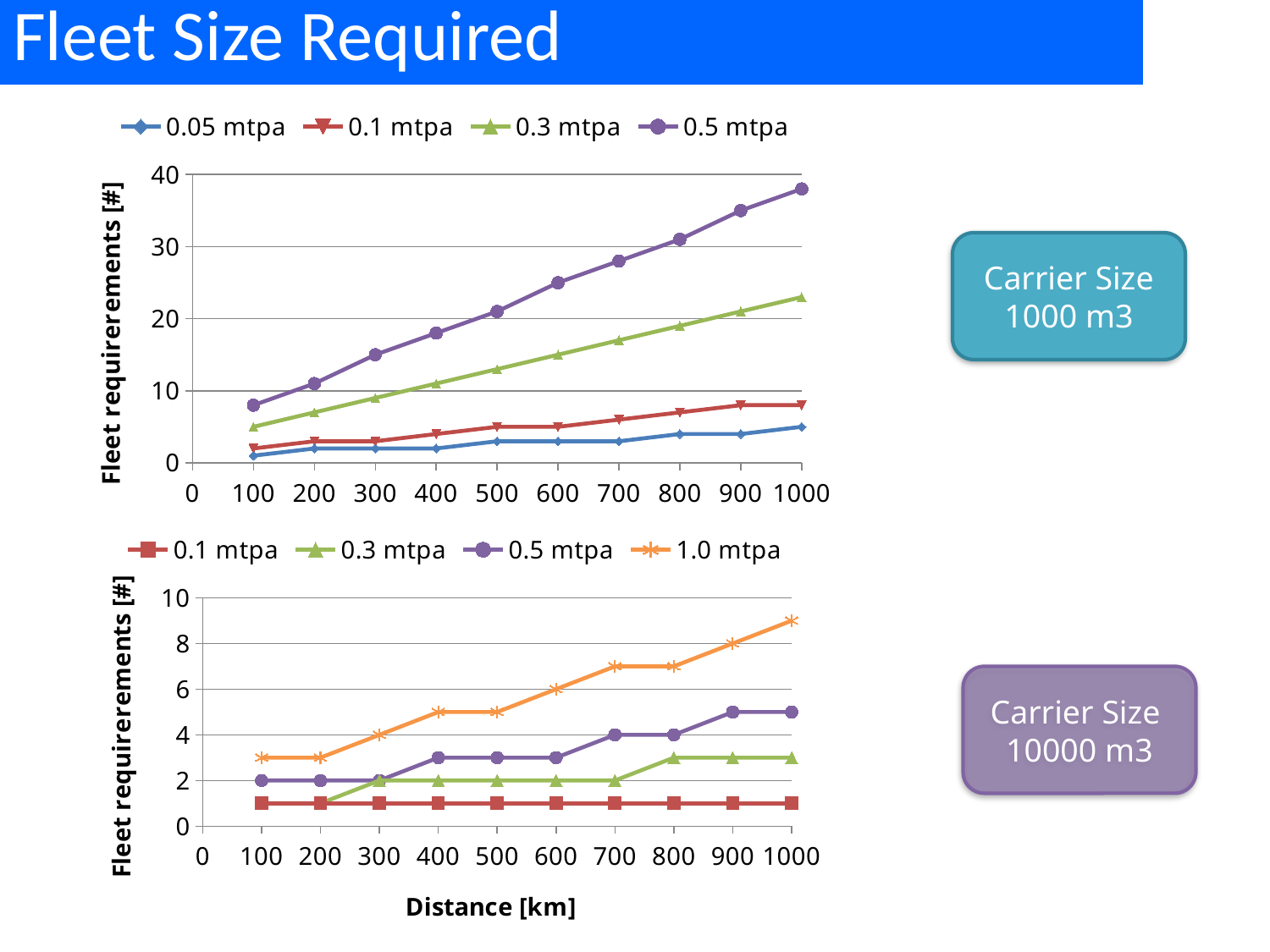
What is the x-axis label of the bottom chart (Carrier Size 10000 m3)? Distance [km] In the bottom chart (Carrier Size 10000 m3), what is the fleet requirement for 1.0 mtpa at 600 km? 6 In the top chart (Carrier Size 1000 m3), is the value for 0.3 mtpa at 500 km greater or less than 10? greater In the top chart (Carrier Size 1000 m3), which series has the highest fleet requirement at 1000 km? 0.5 mtpa In the top chart (Carrier Size 1000 m3), is the value for 0.5 mtpa at 1000 km greater or less than 30? greater How many series does the legend of the top chart (Carrier Size 1000 m3) list? 4 In the top chart (Carrier Size 1000 m3), does the 0.5 mtpa series rise or fall as distance increases? rise What type of chart is the top chart (Carrier Size 1000 m3)? line chart In the bottom chart (Carrier Size 10000 m3), which is larger at 500 km: 1.0 mtpa or 0.5 mtpa? 1.0 mtpa In the bottom chart (Carrier Size 10000 m3), which series has the lowest fleet requirement at 1000 km? 0.1 mtpa In the bottom chart (Carrier Size 10000 m3), what is the fleet requirement for 1.0 mtpa at 900 km? 8 In the bottom chart (Carrier Size 10000 m3), what is the fleet requirement for 0.5 mtpa at 700 km? 4